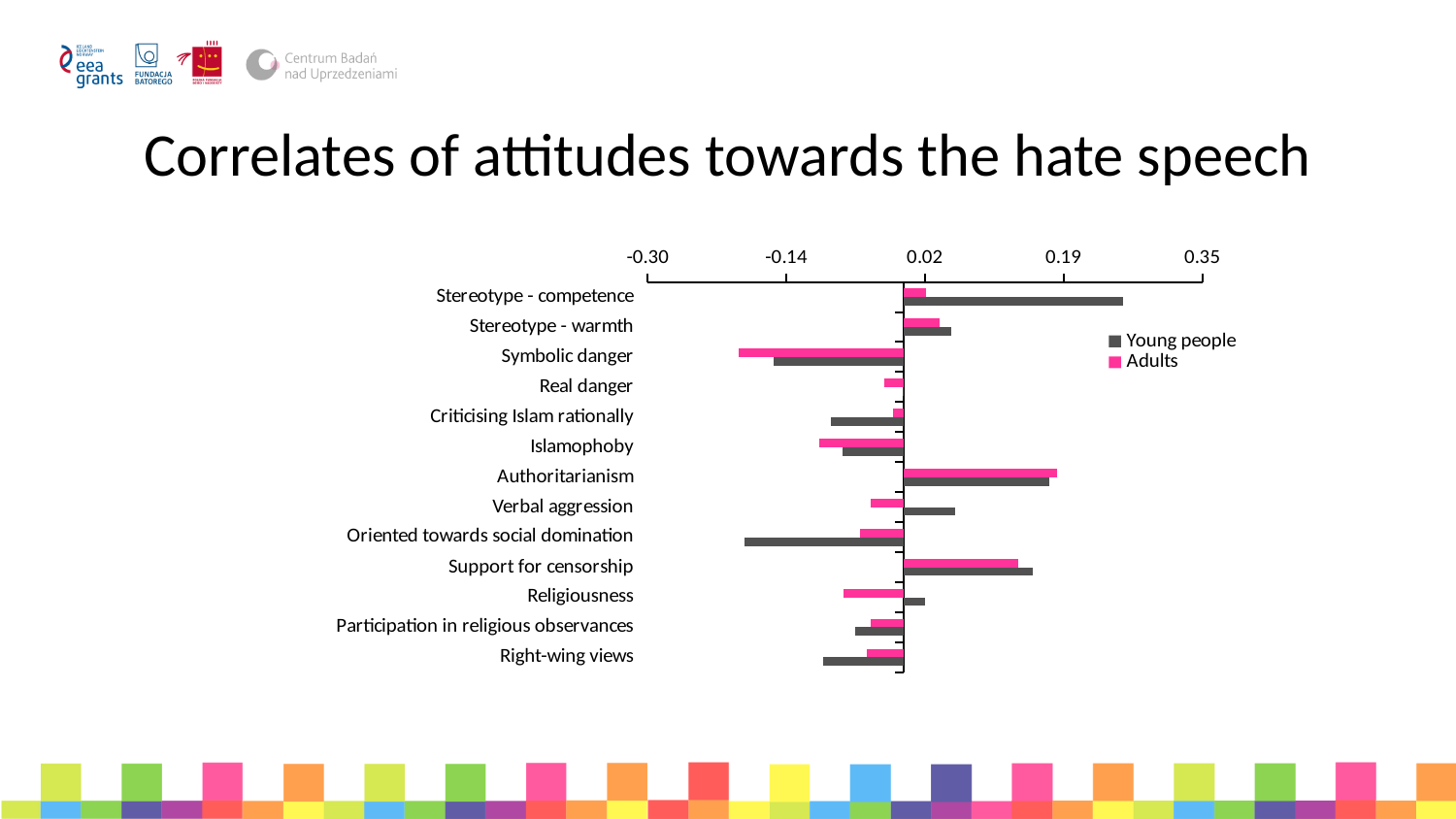
Is the Young people value for Support for censorship greater or less than 0.02? greater Which colour represents the Adults series in the legend? Pink For Stereotype - competence, which series has the larger value, Young people or Adults? Young people For the Adults series, which category has the highest value? Authoritarianism Is the Young people value for Stereotype - competence greater or less than 0.19? greater For the Young people series, which category has the lowest (most negative) value? Oriented towards social domination What kind of chart is shown on the slide? Bar chart For the Young people series, which category has the highest value? Stereotype - competence For the Adults series, which category has the lowest (most negative) value? Symbolic danger Is the Adults value for Symbolic danger greater or less than -0.14? less How many series does the legend list? 2 How many categories are plotted on the vertical axis? 13